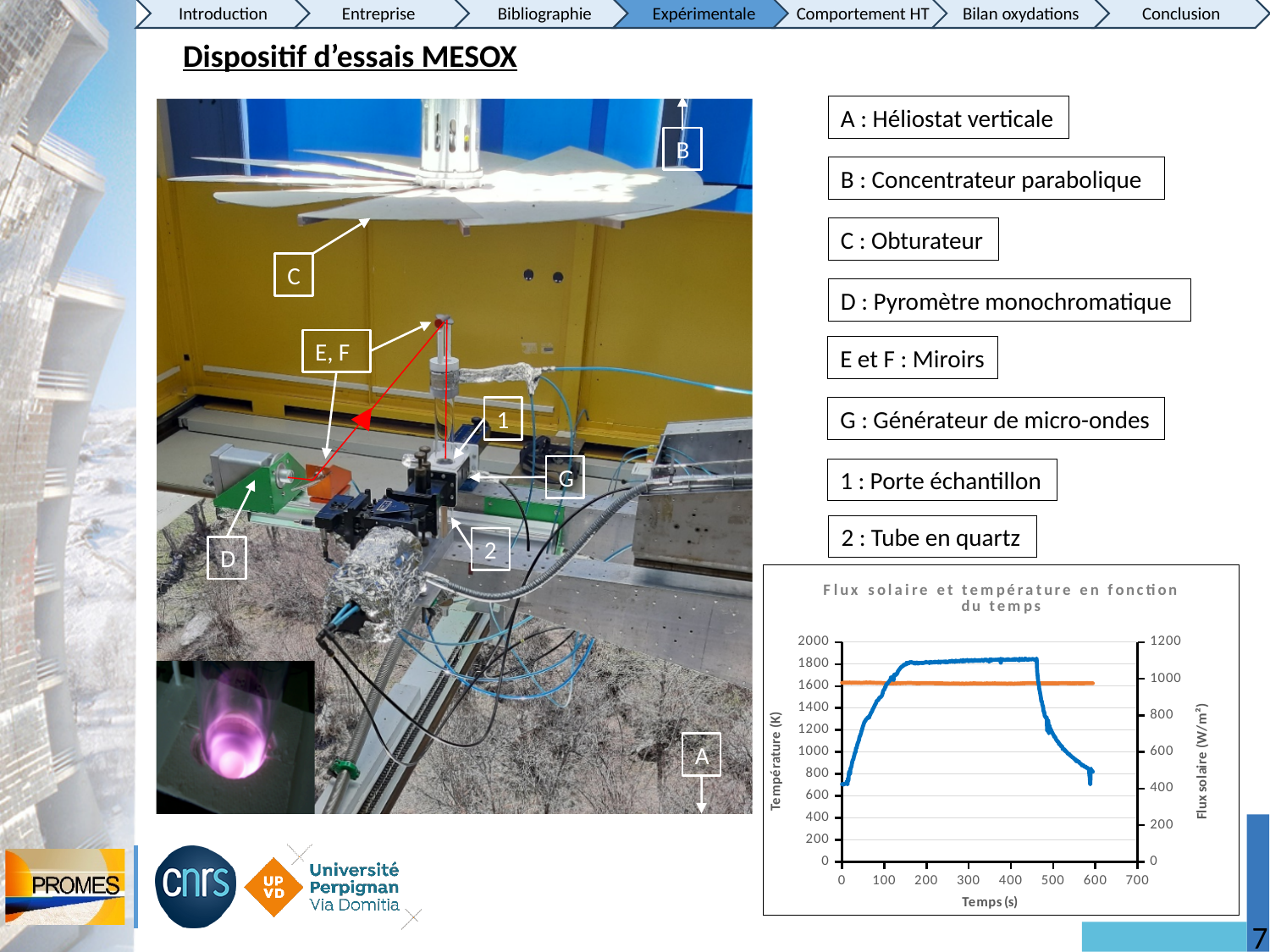
What type of chart is shown on the slide? line chart Does the temperature rise or fall between 450 s and 600 s? fall How many lines are plotted on the chart? 2 Is the temperature at 200 s greater or less than 1400 K? greater Is the solar flux (orange line) at 300 s greater or less than 800 W/m²? greater Is the temperature at 500 s greater or less than 1600 K? less What is the title of the chart on the slide? Flux solaire et température en fonction du temps Which is larger, the temperature at 300 s or the temperature at 0 s? the temperature at 300 s What is the label of the x axis of the chart? Temps (s) Does the temperature rise or fall between 0 s and 150 s? rise